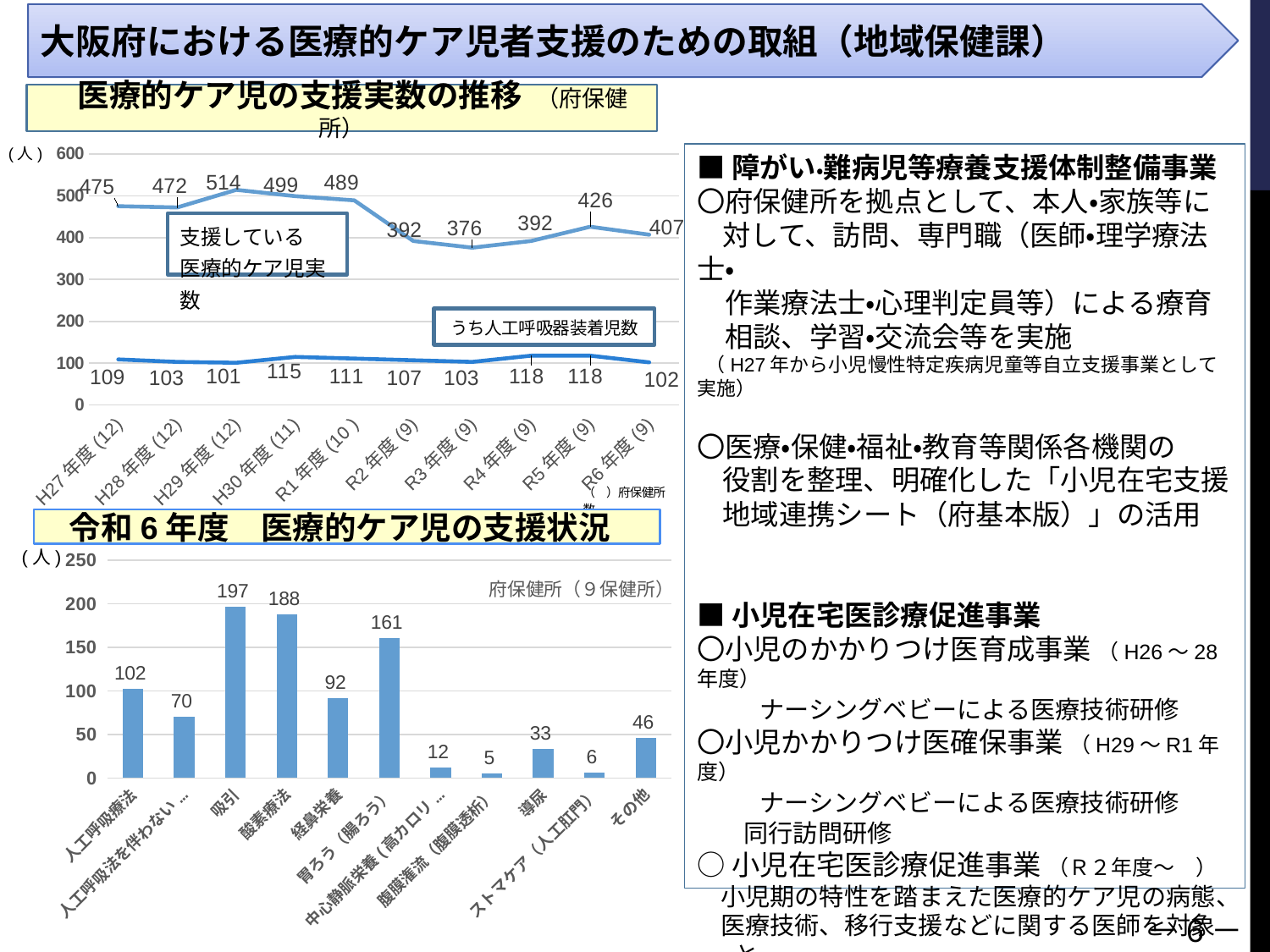
In the top chart '医療的ケア児の支援実数の推移', which year has the highest value of 支援している医療的ケア児実数? H29年度 In the top chart '医療的ケア児の支援実数の推移', how many years are plotted on the x axis? 10 In the bottom chart '令和6年度 医療的ケア児の支援状況', which category has the lowest value? 腹膜潅流（腹膜透析） In the top chart '医療的ケア児の支援実数の推移', which year has the lowest value of 支援している医療的ケア児実数? R3年度 In the top chart '医療的ケア児の支援実数の推移', what is the value of 支援している医療的ケア児実数 for H29年度? 514 In the bottom chart '令和6年度 医療的ケア児の支援状況', which is larger, 酸素療法 or 胃ろう（腸ろう）? 酸素療法 In the top chart '医療的ケア児の支援実数の推移', what type of chart is shown? Line chart In the top chart '医療的ケア児の支援実数の推移', what is the difference between the 支援している医療的ケア児実数 values for R1年度 and R2年度? 97 In the bottom chart '令和6年度 医療的ケア児の支援状況', what type of chart is shown? Bar chart In the top chart '医療的ケア児の支援実数の推移', what is the value of うち人工呼吸器装着児数 for R6年度? 102 In the bottom chart '令和6年度 医療的ケア児の支援状況', what is the value for 吸引? 197